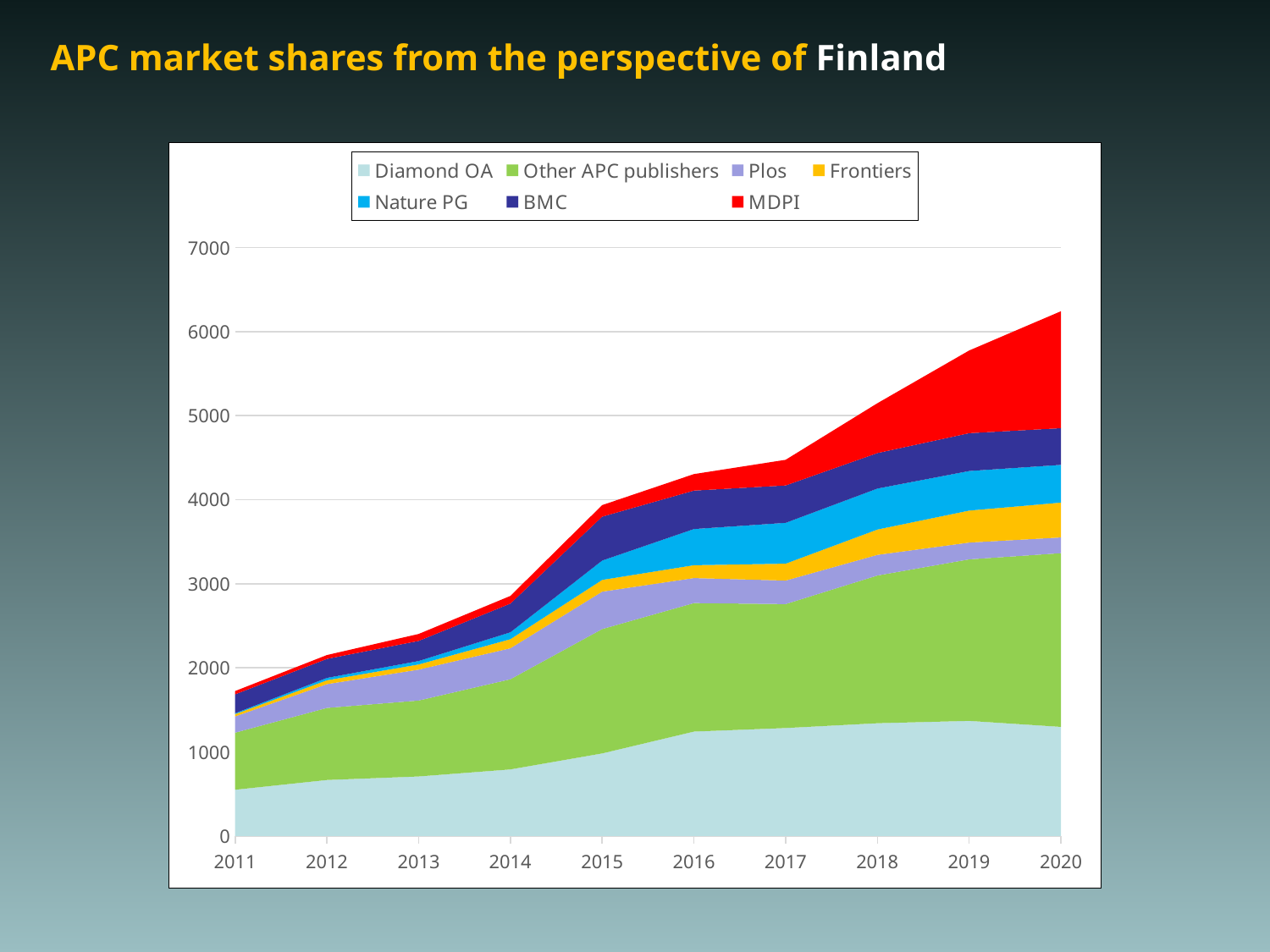
Is the total stacked value for 2017 greater or less than 5000? less Does the total stacked value rise or fall from 2011 to 2020? rise Is the value for Diamond OA in 2020 greater or less than 1000? greater How many series does the legend list? 7 Is the total stacked value for 2020 greater or less than 6000? greater Which series is shown in red in the legend? MDPI What kind of chart is shown on the slide? stacked area chart In which year is the total stacked value lowest? 2011 In which year is the total stacked value highest? 2020 How many years are shown along the x axis? 10